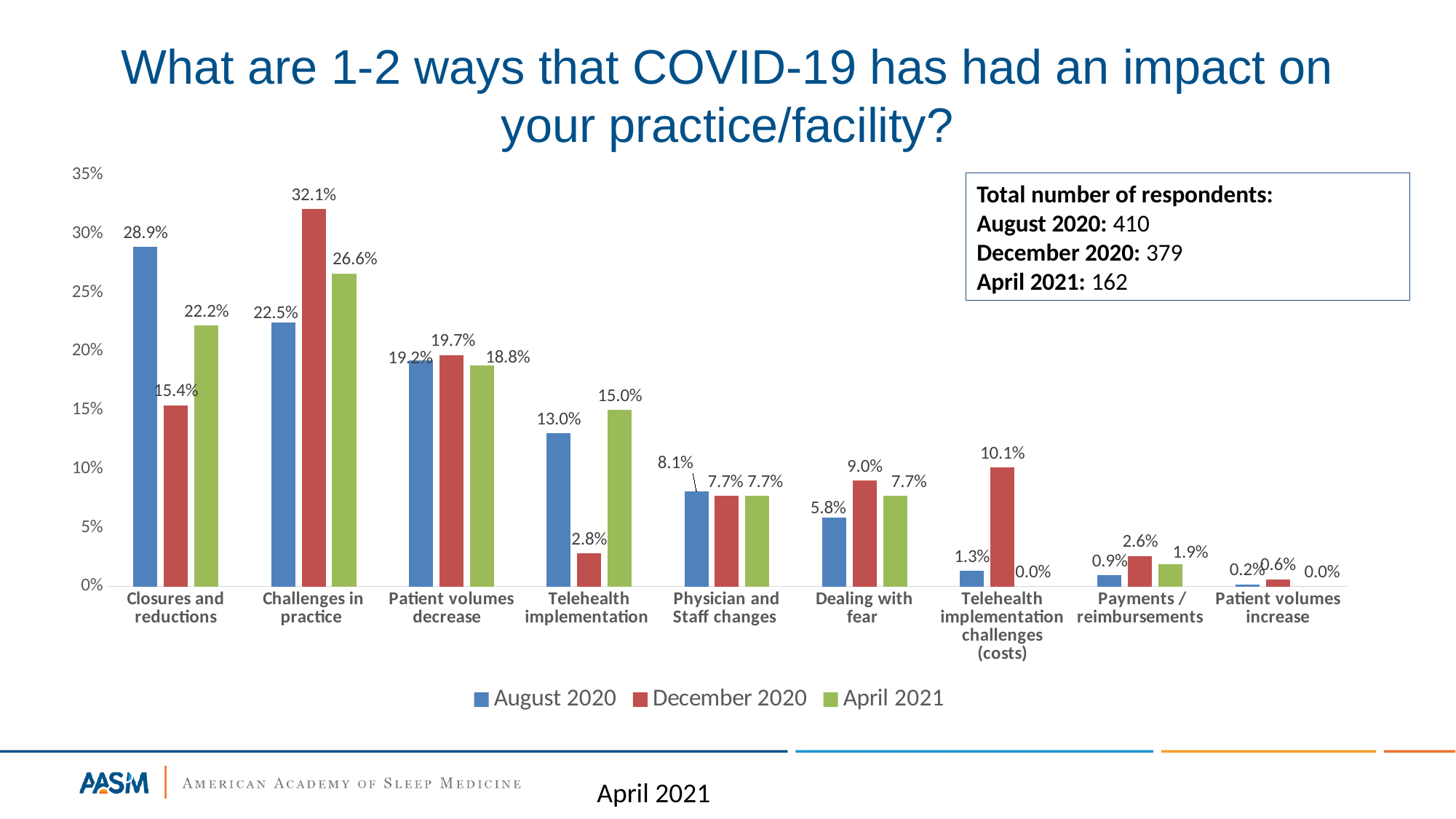
How many categories are shown on the x axis? 9 What is the value for Closures and reductions in August 2020? 28.9% How many respondents were there in April 2021 according to the text box? 162 What kind of chart is shown on the slide? Bar chart What is the value for Telehealth implementation in April 2021? 15.0% What is the value for Challenges in practice in December 2020? 32.1% Which is larger for Dealing with fear: the December 2020 value or the April 2021 value? December 2020 Which category has the highest December 2020 value? Challenges in practice Which category has the lowest August 2020 value? Patient volumes increase Is the April 2021 value for Closures and reductions greater or less than 20%? greater How many series does the legend list? 3 What is the difference between the December 2020 and August 2020 values for Challenges in practice? 9.6%